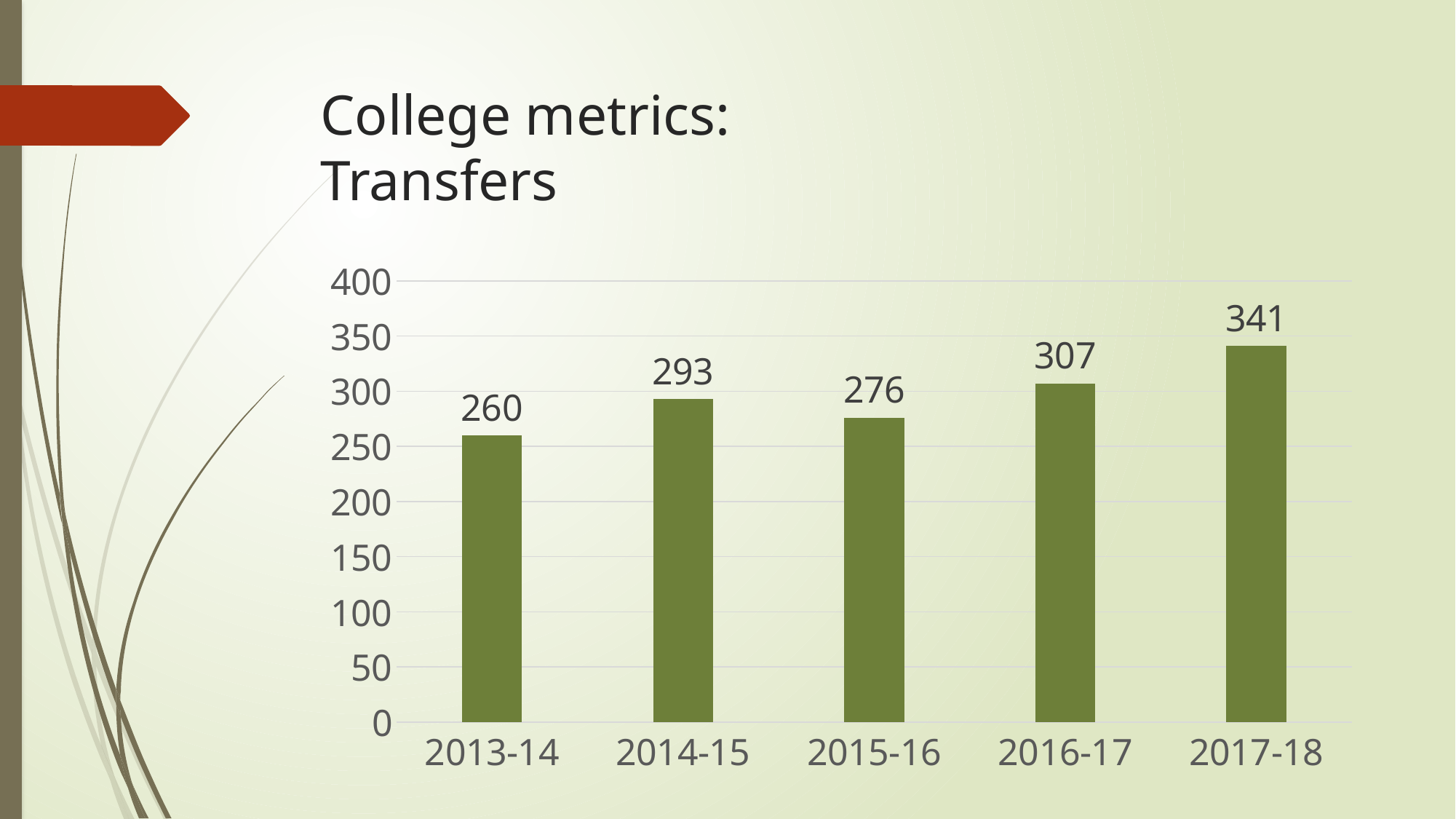
Which is larger, the value for 2014-15 or the value for 2015-16? 2014-15 What is the value for 2013-14? 260 Which year has the highest value? 2017-18 What is the title of the slide? College metrics: Transfers What is the value for 2015-16? 276 What kind of chart is shown on the slide? bar chart What is the value for 2017-18? 341 How many years are shown on the x axis? 5 What is the difference between the values for 2017-18 and 2013-14? 81 Which year has the lowest value? 2013-14 What is the difference between the values for 2014-15 and 2015-16? 17 Is the value for 2016-17 greater or less than 300? greater